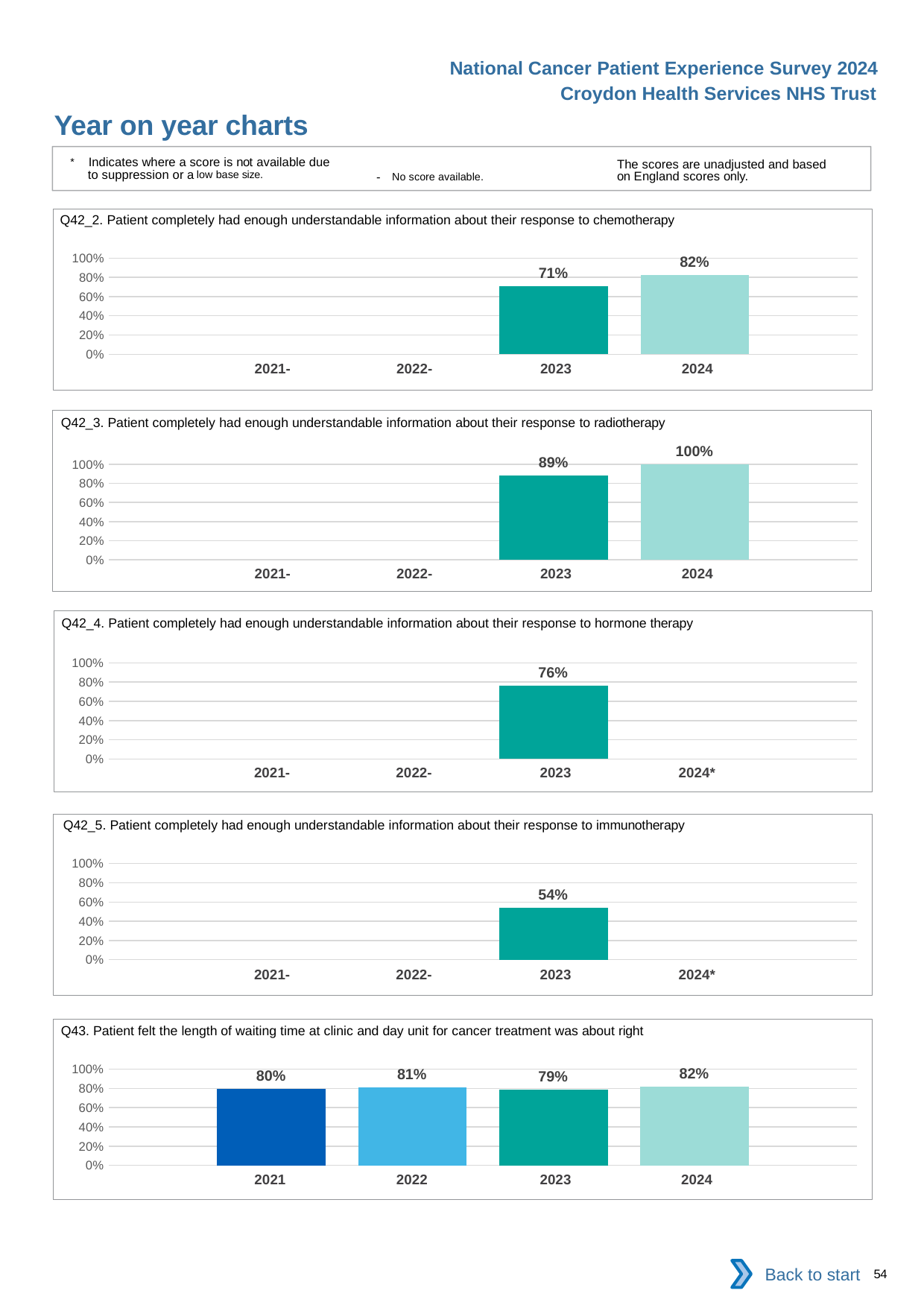
In the Q43 chart (waiting time at clinic and day unit), which year has the lowest value? 2023 In the Q42_2 chart (chemotherapy), what is the difference between the 2024 and 2023 values? 11 percentage points How many charts are shown on the slide? 5 In the Q42_3 chart (radiotherapy), which year has the highest value? 2024 In the Q42_2 chart (chemotherapy), what is the value for 2024? 82% In the Q42_5 chart (immunotherapy), is the value for 2023 greater or less than 60%? less In the Q42_5 chart (immunotherapy), how many years have a bar plotted? 1 What kind of chart is the Q43 chart (waiting time at clinic and day unit)? Bar chart In the Q42_4 chart (hormone therapy), what is the value for 2023? 76% In the Q42_3 chart (radiotherapy), what is the value for 2023? 89% In the Q43 chart (waiting time at clinic and day unit), what is the value for 2022? 81% In the Q43 chart (waiting time at clinic and day unit), which is larger, the 2021 value or the 2024 value? 2024